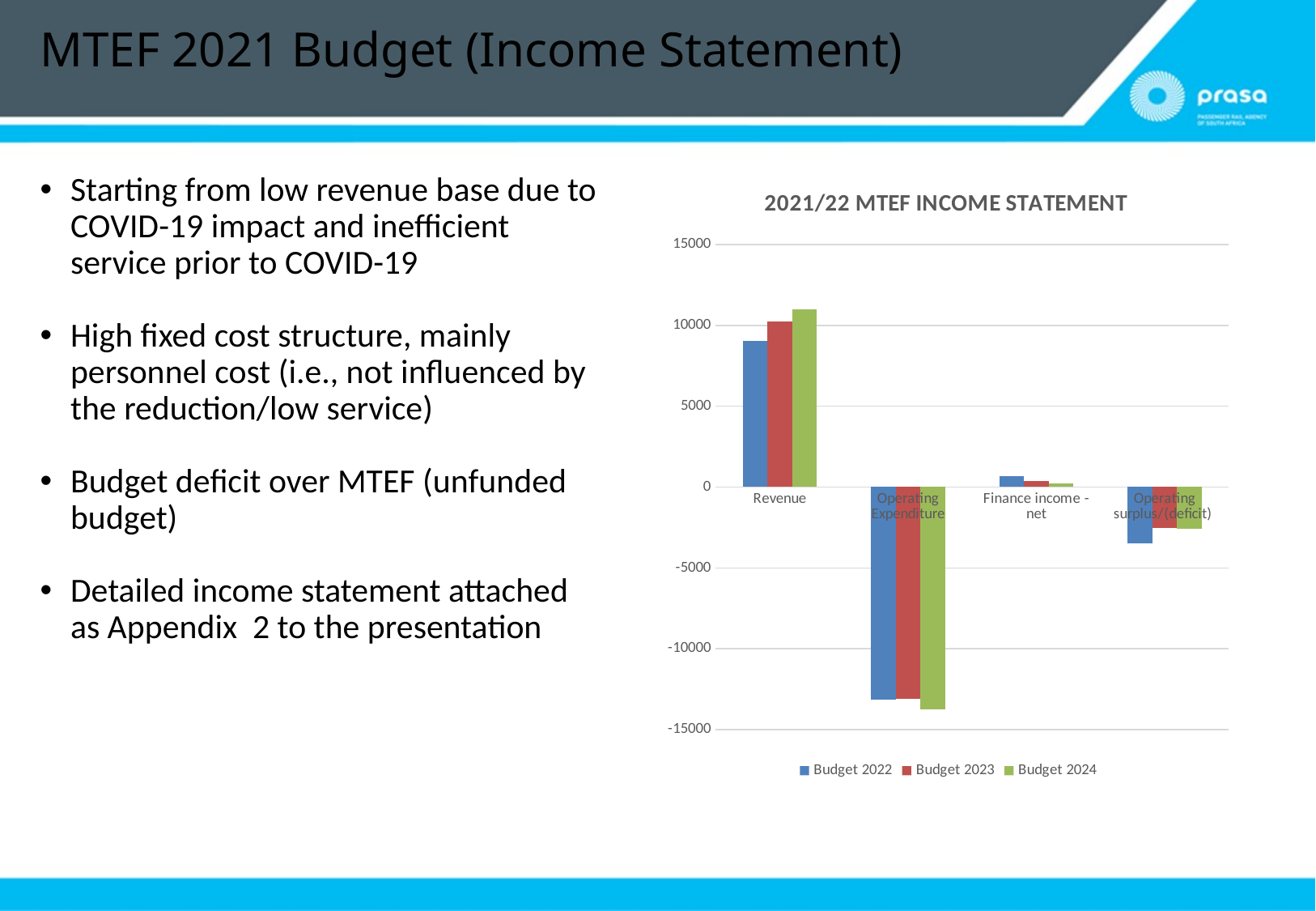
Is the Finance income - net value for Budget 2022 greater or less than 5000? less Is the Operating Expenditure value for Budget 2024 greater or less than -10000? less Is the Revenue value for Budget 2024 greater or less than 10000? greater Which category has the highest values across all series? Revenue What type of chart is shown on the slide? bar chart Which category has the lowest values across all series? Operating Expenditure How many categories are shown on the x axis? 4 Which series are listed in the legend? Budget 2022, Budget 2023, Budget 2024 How many series does the legend list? 3 What is the title of the chart? 2021/22 MTEF INCOME STATEMENT For Revenue, which is larger: Budget 2022 or Budget 2024? Budget 2024